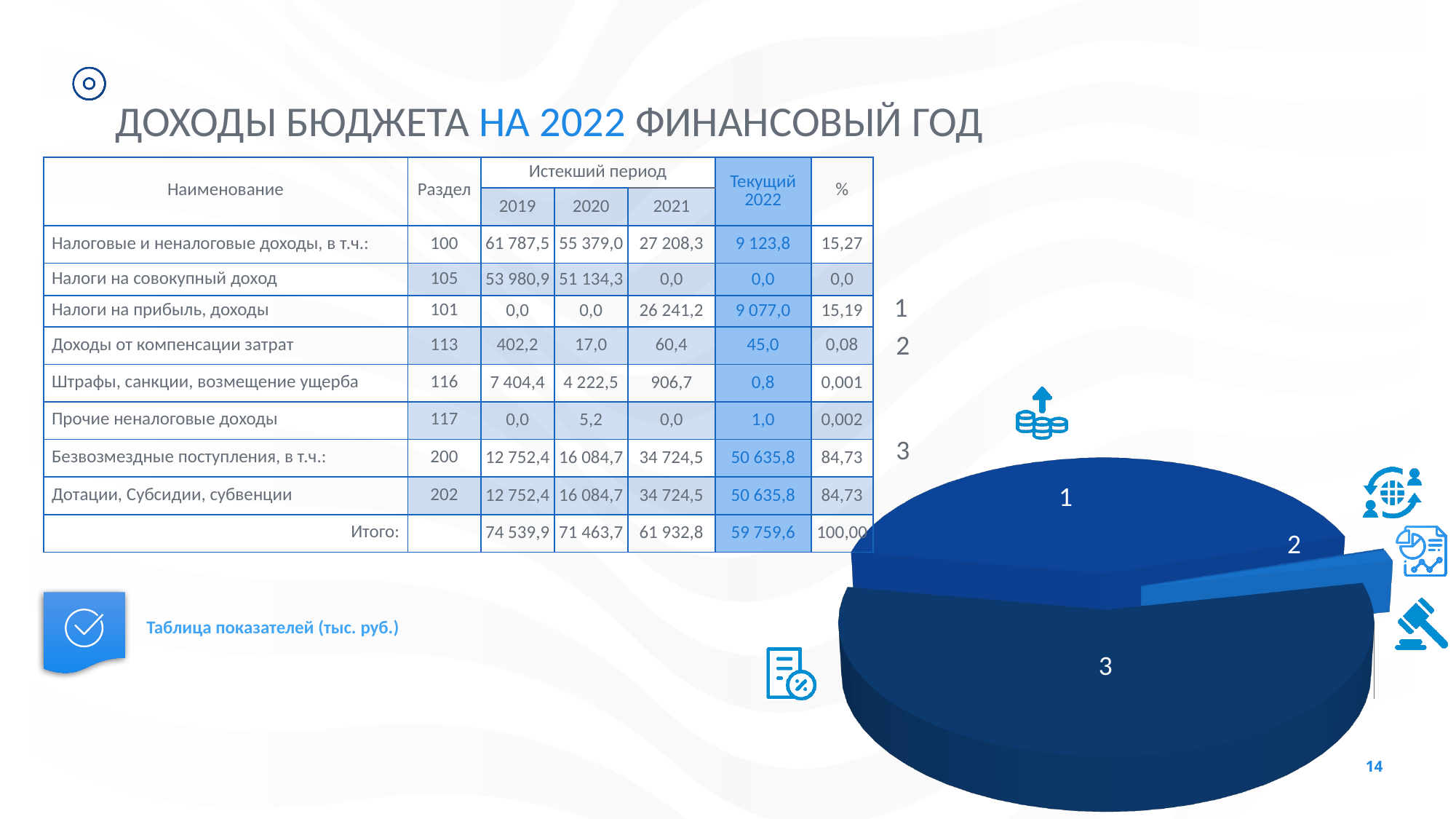
In the pie chart, which slice is larger, slice 1 or slice 2? 1 Does slice 1 of the pie chart take up more or less than half of the pie? less What kind of chart is shown on the right side of the slide? pie chart How many slices does the pie chart on the right have? 3 In the pie chart, which slice is larger, slice 1 or slice 3? 3 What labels are printed on the slices of the pie chart? 1, 2, 3 Which slice of the pie chart is the smallest? 2 Is the pie chart drawn in 3D or flat 2D? 3D Does slice 3 of the pie chart take up more or less than half of the pie? more Which slice of the pie chart is the largest? 3